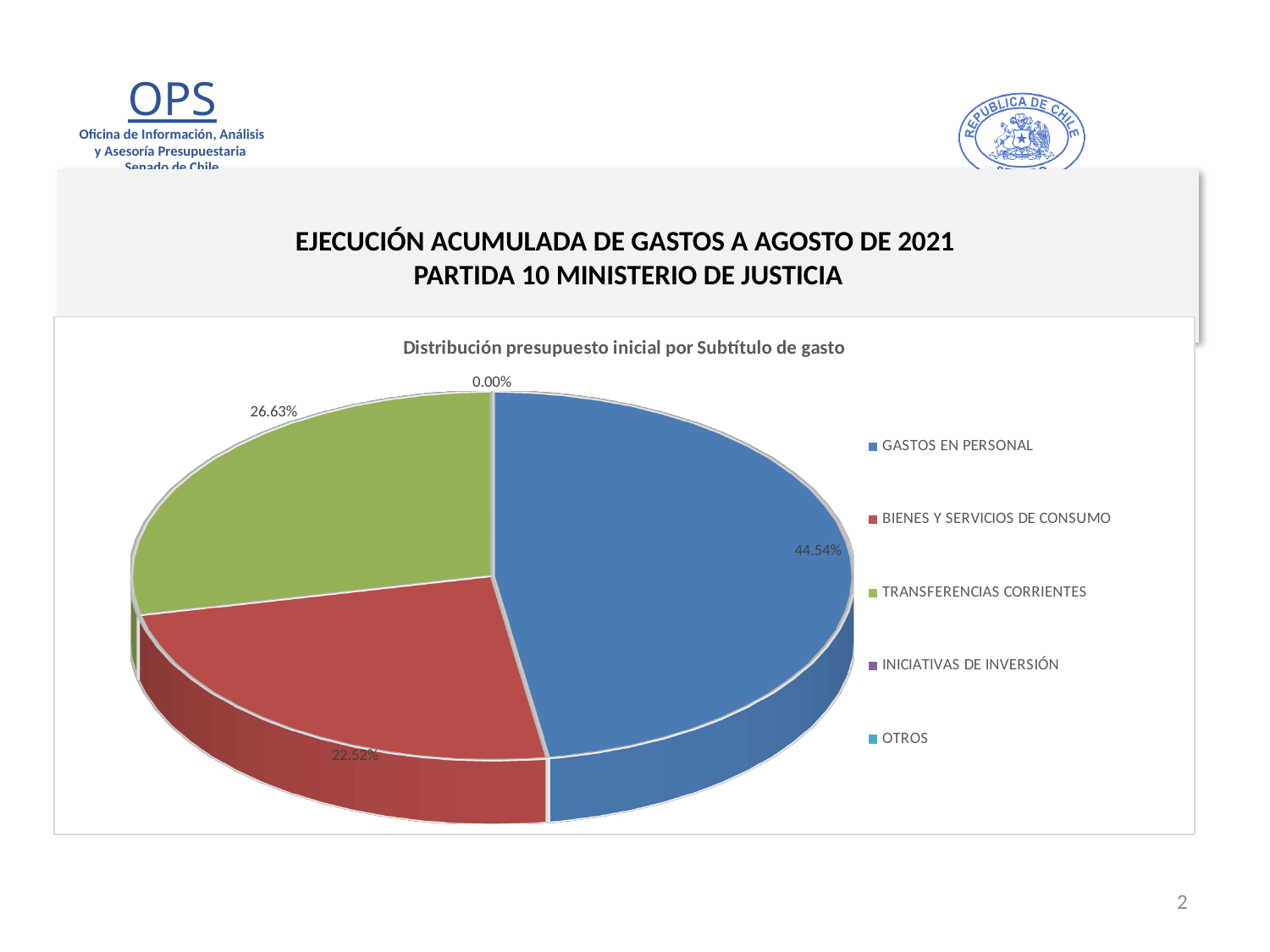
What kind of chart is shown on the slide? Pie chart Which is larger, the slice for TRANSFERENCIAS CORRIENTES or the slice for BIENES Y SERVICIOS DE CONSUMO? TRANSFERENCIAS CORRIENTES Which category has the largest slice of the pie? GASTOS EN PERSONAL What share of the pie does GASTOS EN PERSONAL represent? 44.54% What percentage is shown for TRANSFERENCIAS CORRIENTES? 26.63% What is the difference in percentage points between GASTOS EN PERSONAL and BIENES Y SERVICIOS DE CONSUMO? 22.02 What percentage is shown for BIENES Y SERVICIOS DE CONSUMO? 22.52% Is the share for GASTOS EN PERSONAL greater or less than 50%? less Which colour represents GASTOS EN PERSONAL in the chart? Blue What is the title of the chart? Distribución presupuesto inicial por Subtítulo de gasto What is the difference in percentage points between TRANSFERENCIAS CORRIENTES and BIENES Y SERVICIOS DE CONSUMO? 4.11 How many categories does the legend list? 5